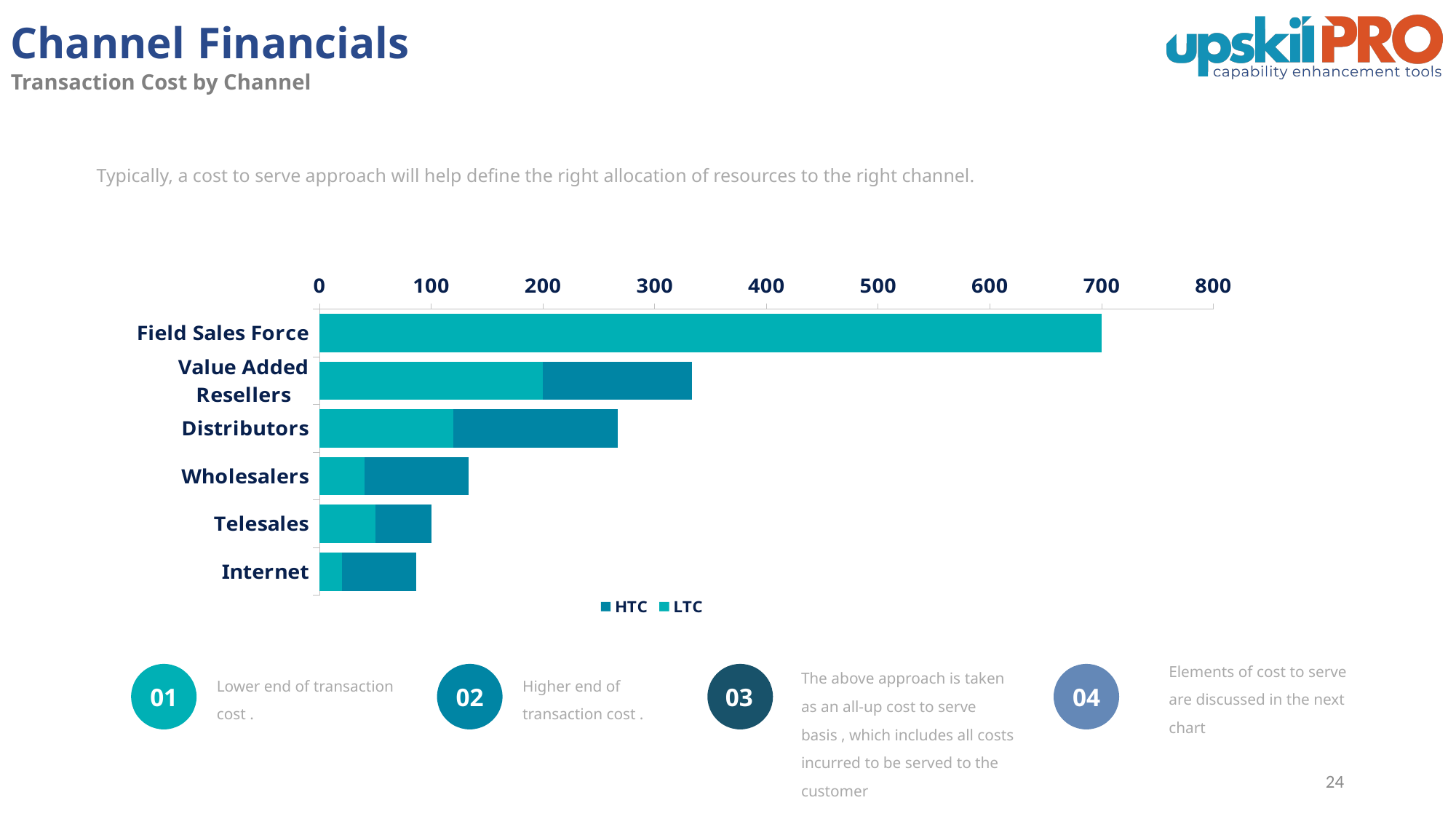
Is the total bar for Field Sales Force greater or less than 600? greater Is the total bar for Value Added Resellers greater or less than 300? greater What is the subtitle describing the chart on the slide? Transaction Cost by Channel Which channel has the shortest total bar in the chart? Internet Is the total bar for Internet greater or less than 100? less What kind of chart is shown on the slide? bar chart Which channel has the longest total bar in the chart? Field Sales Force How many series does the chart legend list? 2 Which channel has the larger total bar, Distributors or Wholesalers? Distributors What are the two series names shown in the chart legend? HTC and LTC How many channels (categories) are plotted in the chart? 6